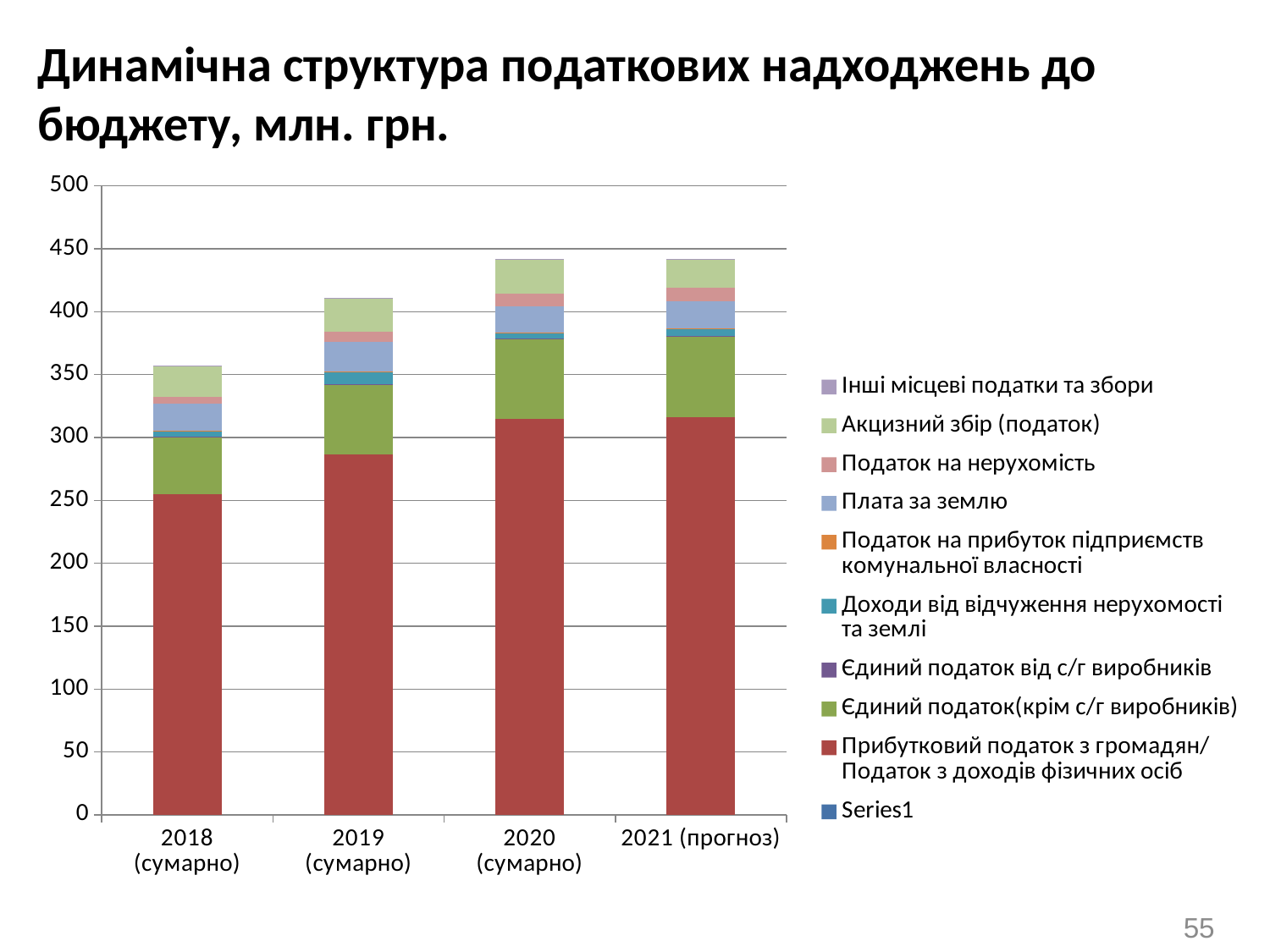
Is the 'Прибутковий податок з громадян/ Податок з доходів фізичних осіб' segment for 2020 (сумарно) greater or less than 300? greater Is the total bar for 2018 (сумарно) greater or less than 400? less Is the total bar for 2020 (сумарно) greater or less than 400? greater Do the total bar heights generally rise or fall from 2018 to 2021? rise Which total bar is taller, 2018 (сумарно) or 2019 (сумарно)? 2019 (сумарно) What kind of chart is shown on the slide? stacked bar chart Which category has the lowest total bar height? 2018 (сумарно) How many categories are shown on the x axis? 4 What is the title of the chart? Динамічна структура податкових надходжень до бюджету, млн. грн. How many series does the legend list? 10